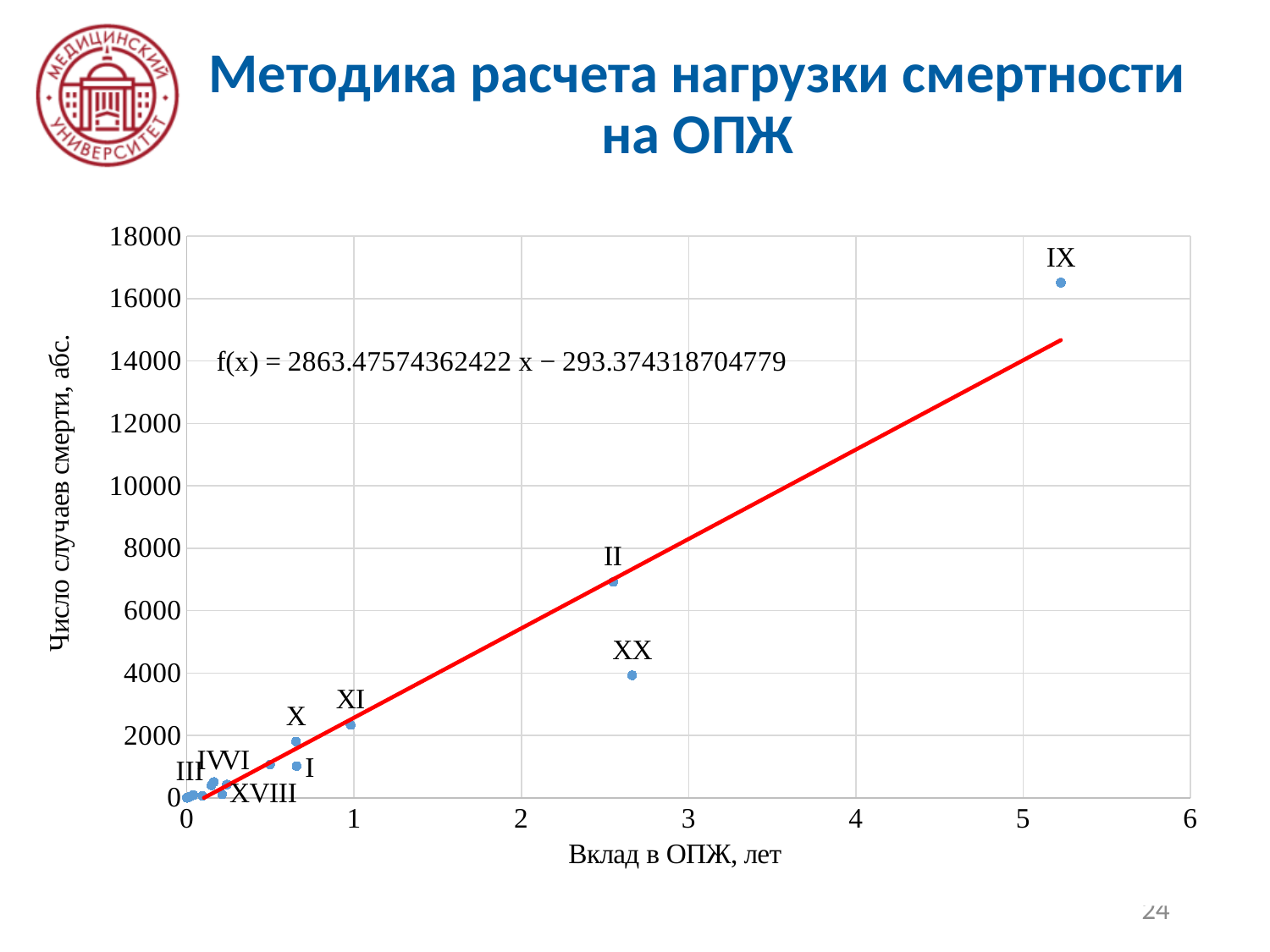
Is the number of deaths for point IX greater or less than 16000? greater Which point has more deaths, IX or II? IX Does the red trend line rise or fall as the contribution to life expectancy increases? rises Is the number of deaths for point XX greater or less than 6000? less Is the number of deaths for point II greater or less than 8000? less What is the title of the x axis of the chart? Вклад в ОПЖ, лет Which labelled point has the highest number of deaths (Число случаев смерти)? IX Which point has more deaths, II or XX? II What kind of chart is shown on the slide? scatter chart